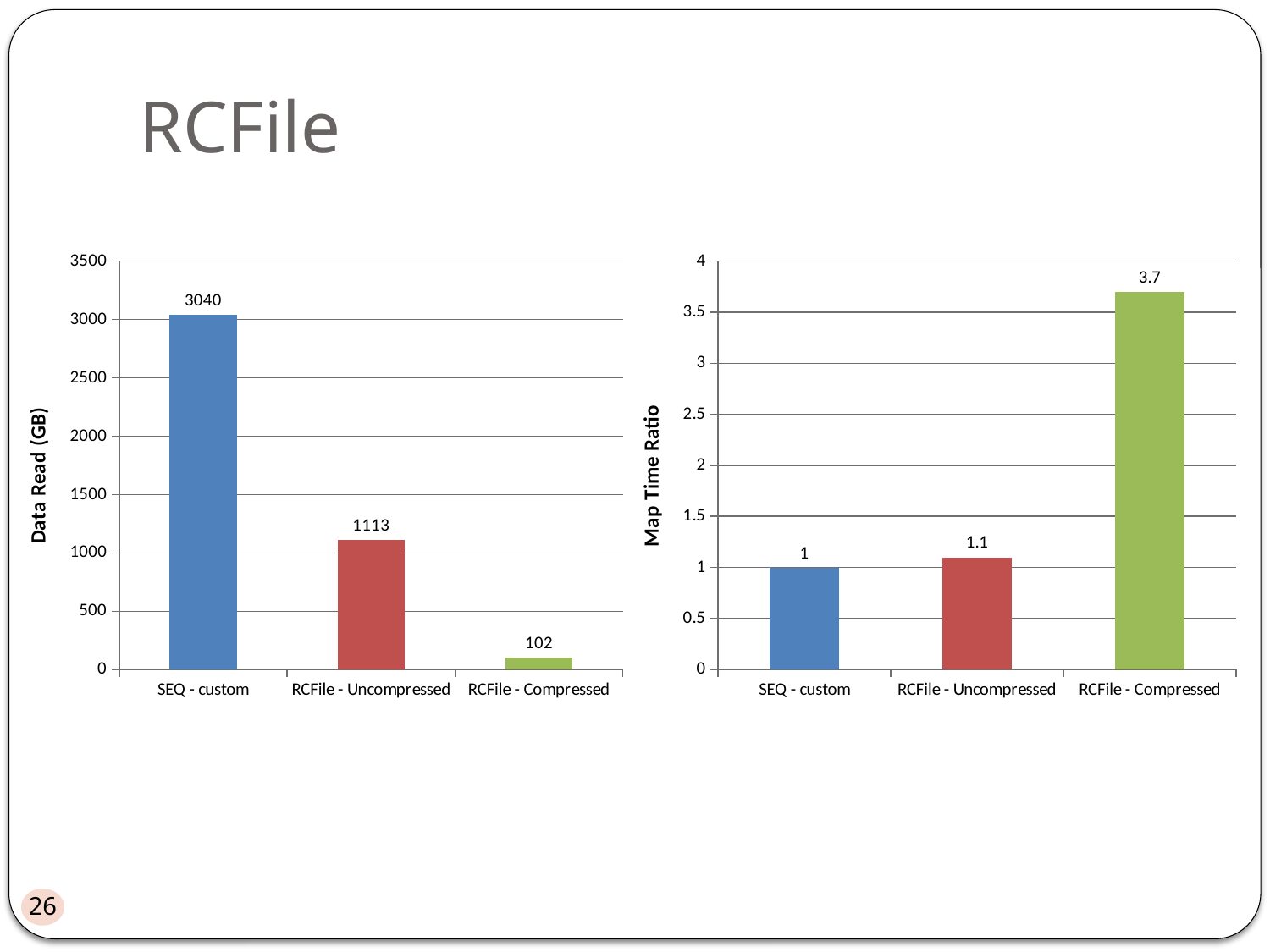
In the left chart (Data Read (GB)), which is larger: RCFile - Uncompressed or RCFile - Compressed? RCFile - Uncompressed How many categories are shown in the left chart (Data Read (GB))? 3 In the right chart (Map Time Ratio), is the value for RCFile - Compressed greater or less than 3? greater In the left chart (Data Read (GB)), what is the value for RCFile - Compressed? 102 In the left chart (Data Read (GB)), what is the difference between SEQ - custom and RCFile - Uncompressed? 1927 What kind of chart is the right chart (Map Time Ratio)? bar chart What is the y-axis label of the left chart? Data Read (GB) In the right chart (Map Time Ratio), which category has the highest value? RCFile - Compressed In the right chart (Map Time Ratio), what is the value for RCFile - Uncompressed? 1.1 In the left chart (Data Read (GB)), what is the value for SEQ - custom? 3040 In the right chart (Map Time Ratio), what is the difference between RCFile - Compressed and SEQ - custom? 2.7 In the left chart (Data Read (GB)), which category has the lowest value? RCFile - Compressed